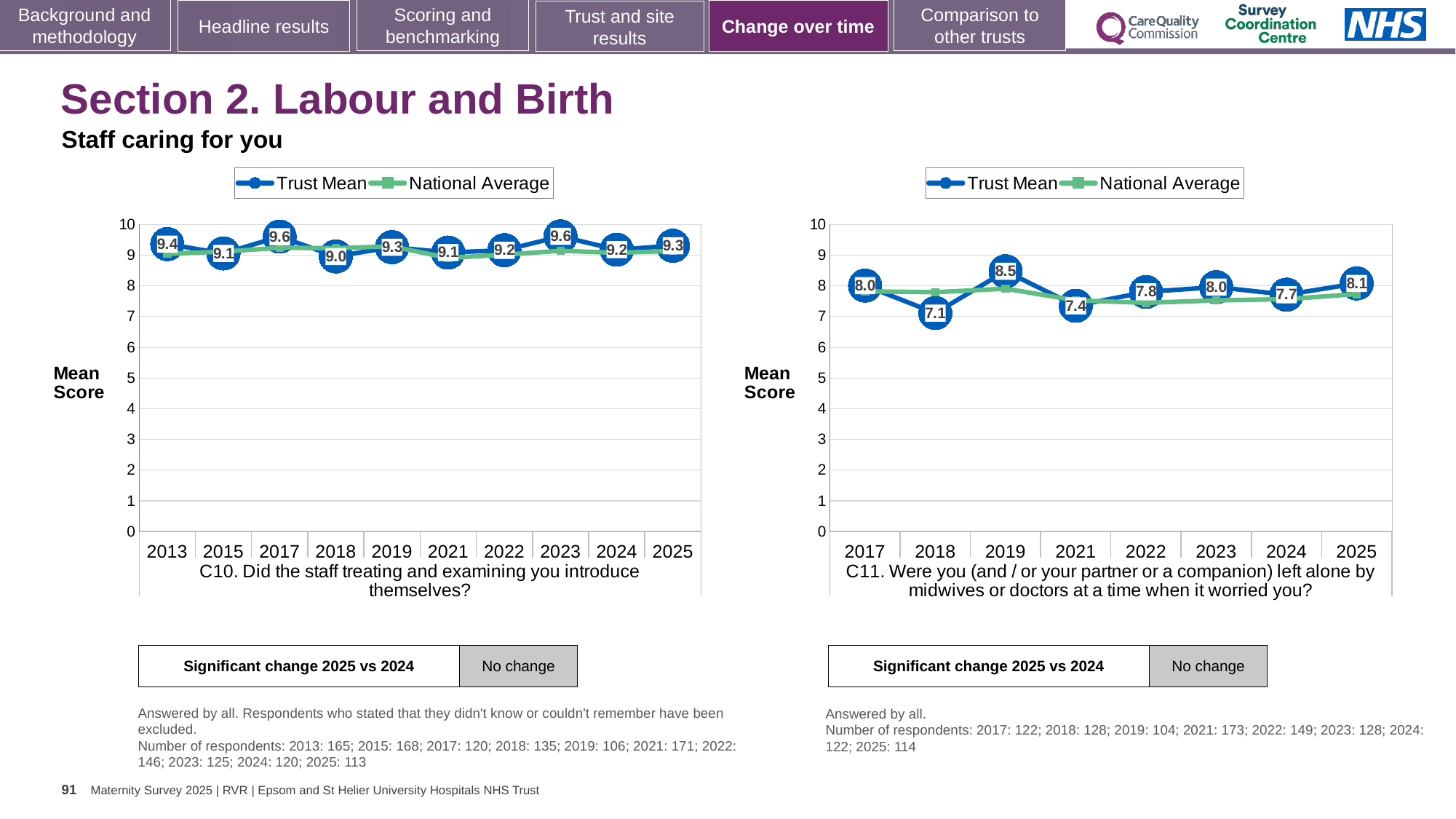
What kind of chart is the C10 chart on the left? Line chart In the C10 chart on the left, which year has the lowest Trust Mean? 2018 In the C11 chart on the right, is the National Average for 2018 greater or less than 7? greater In the C10 chart on the left, what is the Trust Mean for 2018? 9.0 In the C10 chart on the left, how many years are shown on the x axis? 10 In the C10 chart on the left, what is the difference between the Trust Mean for 2017 and for 2018? 0.6 How many series does the legend of the C11 chart on the right list? 2 In the C11 chart on the right, is the Trust Mean for 2024 or for 2025 larger? 2025 In the C11 chart on the right, which year has the lowest Trust Mean? 2018 In the C11 chart on the right, which year has the highest Trust Mean? 2019 In the C10 chart on the left, what is the Trust Mean for 2025? 9.3 In the C11 chart on the right, what is the Trust Mean for 2019? 8.5